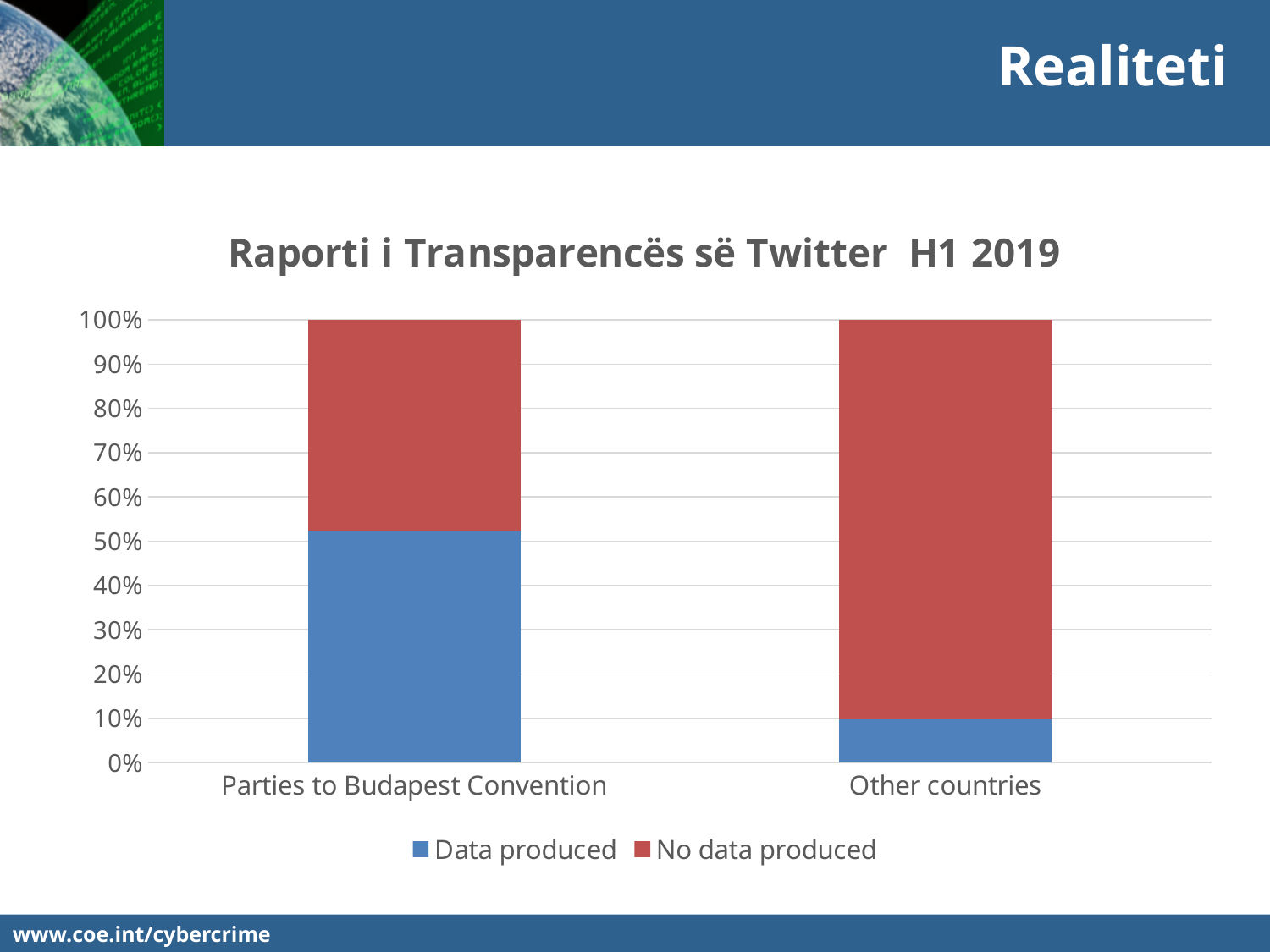
Which colour represents the No data produced series? red How many categories are shown on the x axis? 2 Is the Data produced value for Parties to Budapest Convention greater or less than 40%? greater Is the No data produced value for Other countries greater or less than 80%? greater Which category has the higher value for Data produced? Parties to Budapest Convention Is the Data produced value for Other countries greater or less than 20%? less Which is larger: No data produced for Other countries or No data produced for Parties to Budapest Convention? Other countries Which category has the lower value for Data produced? Other countries How many series does the legend list? 2 What kind of chart is shown on the slide? stacked bar chart What is the title of the chart? Raporti i Transparencës së Twitter H1 2019 What is the total height of the stacked bar for Other countries? 100%